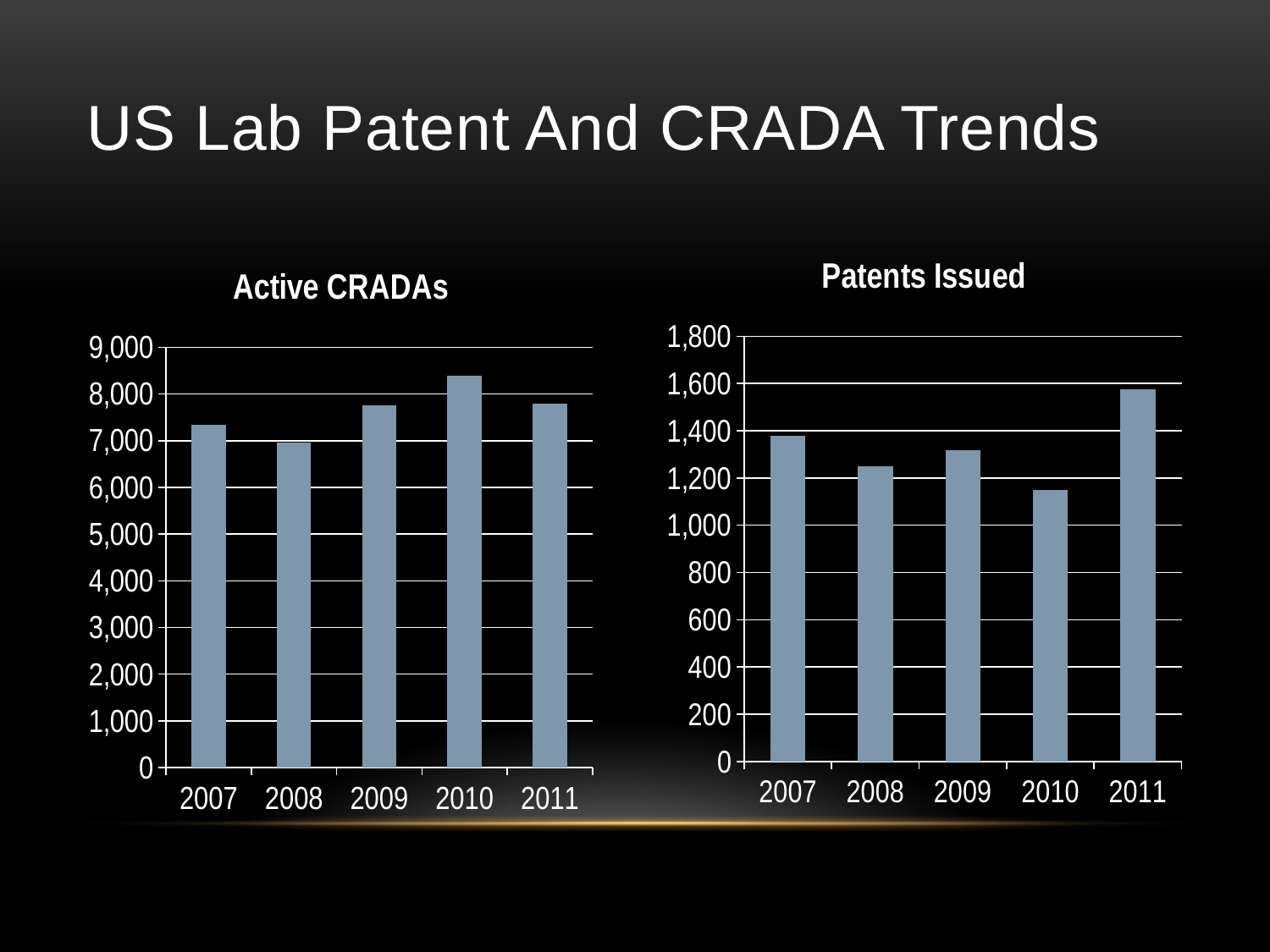
On the Patents Issued chart, which year has the lowest value? 2010 On the Patents Issued chart, is the value for 2011 greater or less than 1,400? greater On the Patents Issued chart, which year has the highest value? 2011 How many years are shown on the Patents Issued chart? 5 On the Patents Issued chart, which year has the larger value, 2008 or 2010? 2008 On the Active CRADAs chart, which year has the larger value, 2007 or 2010? 2010 On the Active CRADAs chart, which year has the highest value? 2010 On the Active CRADAs chart, is the value for 2010 greater or less than 8,000? greater On the Active CRADAs chart, which year has the lowest value? 2008 What kind of chart is the Active CRADAs chart? Bar chart On the Patents Issued chart, is the value for 2010 greater or less than 1,200? less